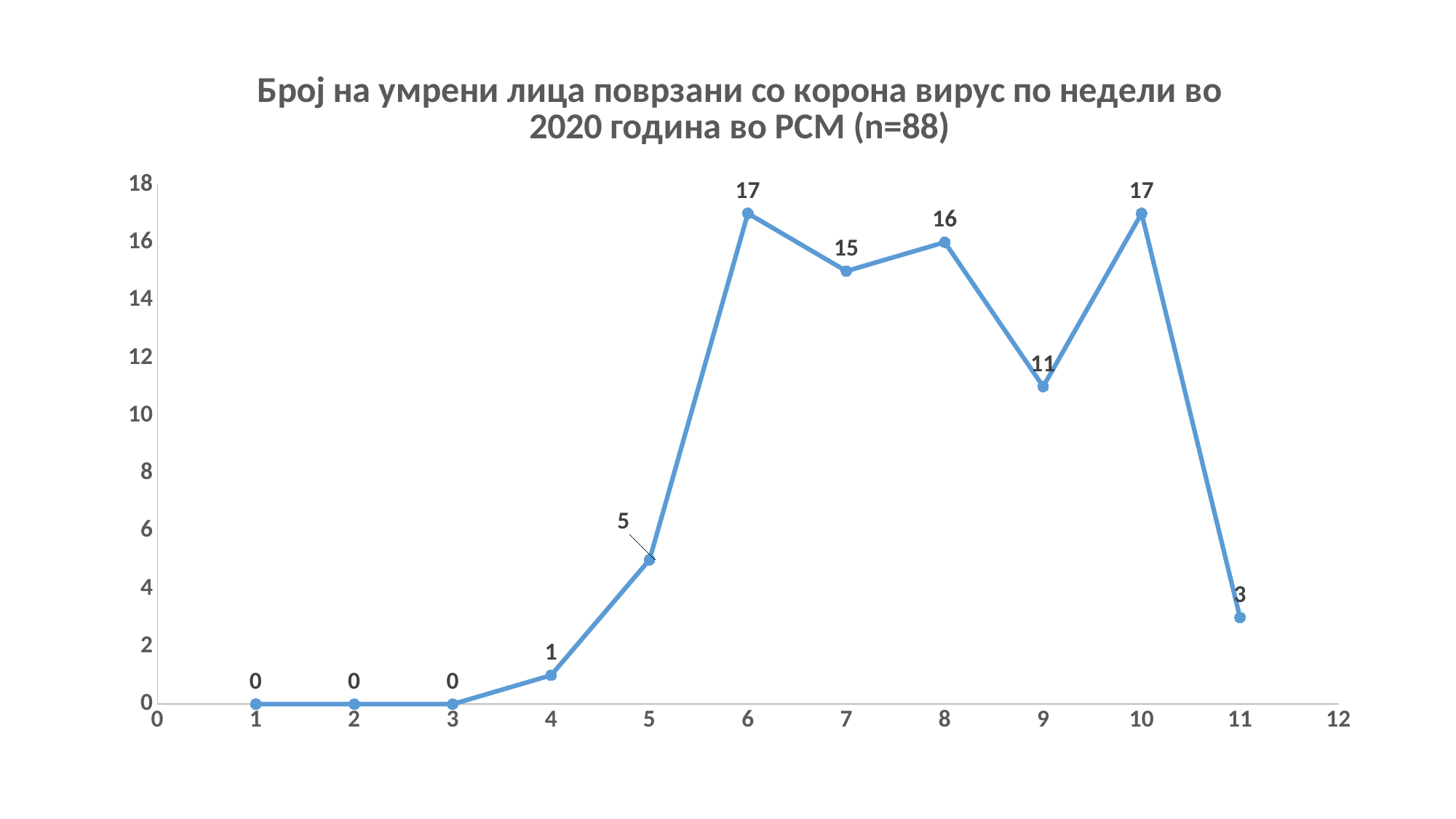
What is the lowest value plotted on the chart? 0 What is the highest value plotted on the chart? 17 What is the difference between the values for week 8 and week 9? 5 What is the value for week 6? 17 What is the value for week 11? 3 What is the value for week 5? 5 What is the value for week 9? 11 Do the values rise or fall from week 3 to week 6? rise What is the difference between the values for week 10 and week 11? 14 What type of chart is shown on the slide? line chart How many data points are plotted on the chart? 11 Which is larger, the value for week 7 or the value for week 8? week 8